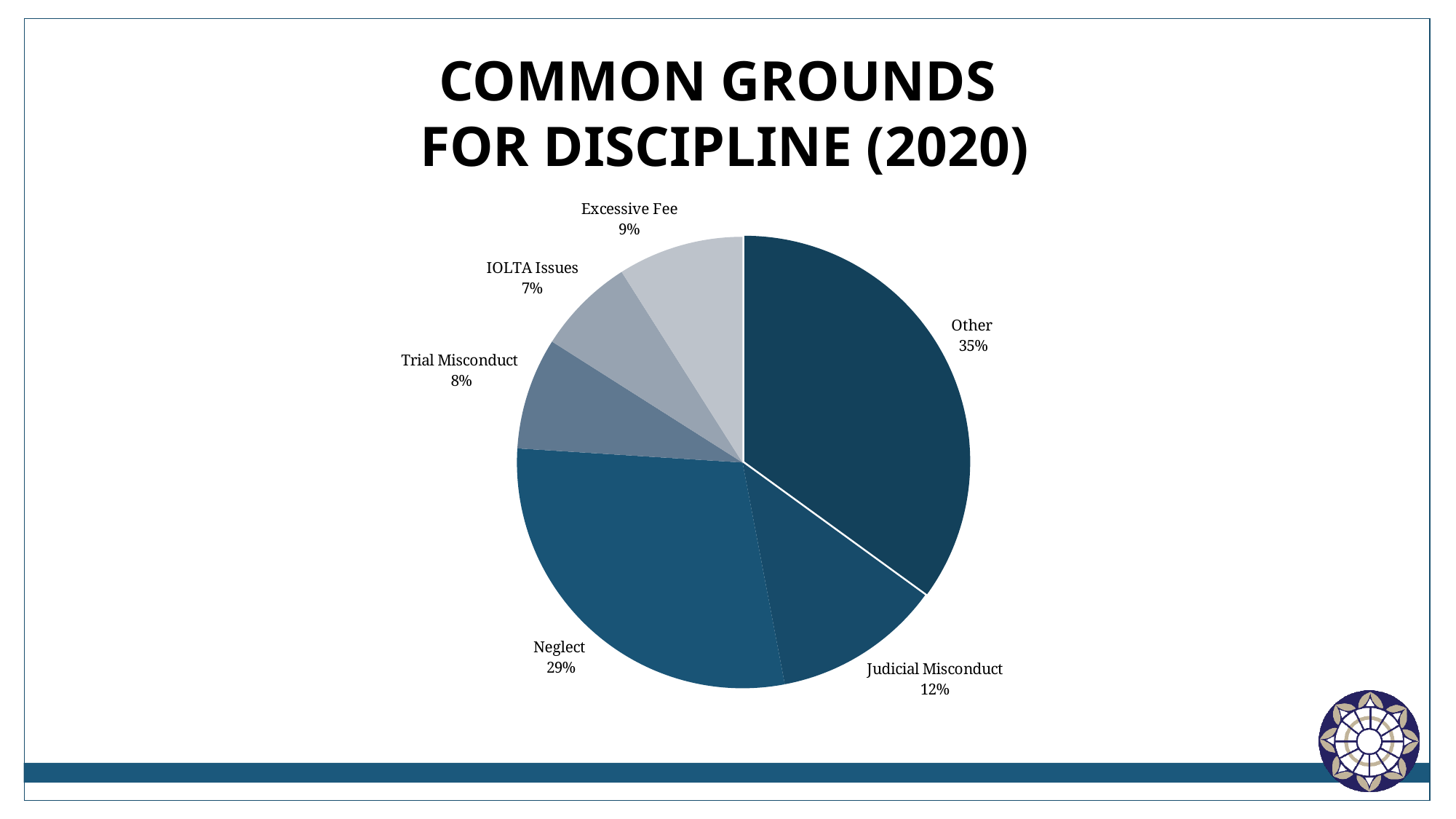
Which is larger, Trial Misconduct or Excessive Fee? Excessive Fee Which category has the largest share of the pie? Other What is the combined percentage of Neglect and Judicial Misconduct? 41% What percentage of the pie is Neglect? 29% How many categories are shown in the pie chart? 6 What is the title of the chart? COMMON GROUNDS FOR DISCIPLINE (2020) What type of chart is shown on the slide? pie chart Which category has the smallest share of the pie? IOLTA Issues What percentage is shown for Excessive Fee? 9% What percentage is shown for Judicial Misconduct? 12% What percentage is shown for IOLTA Issues? 7% What is the difference in percentage points between Other and Neglect? 6